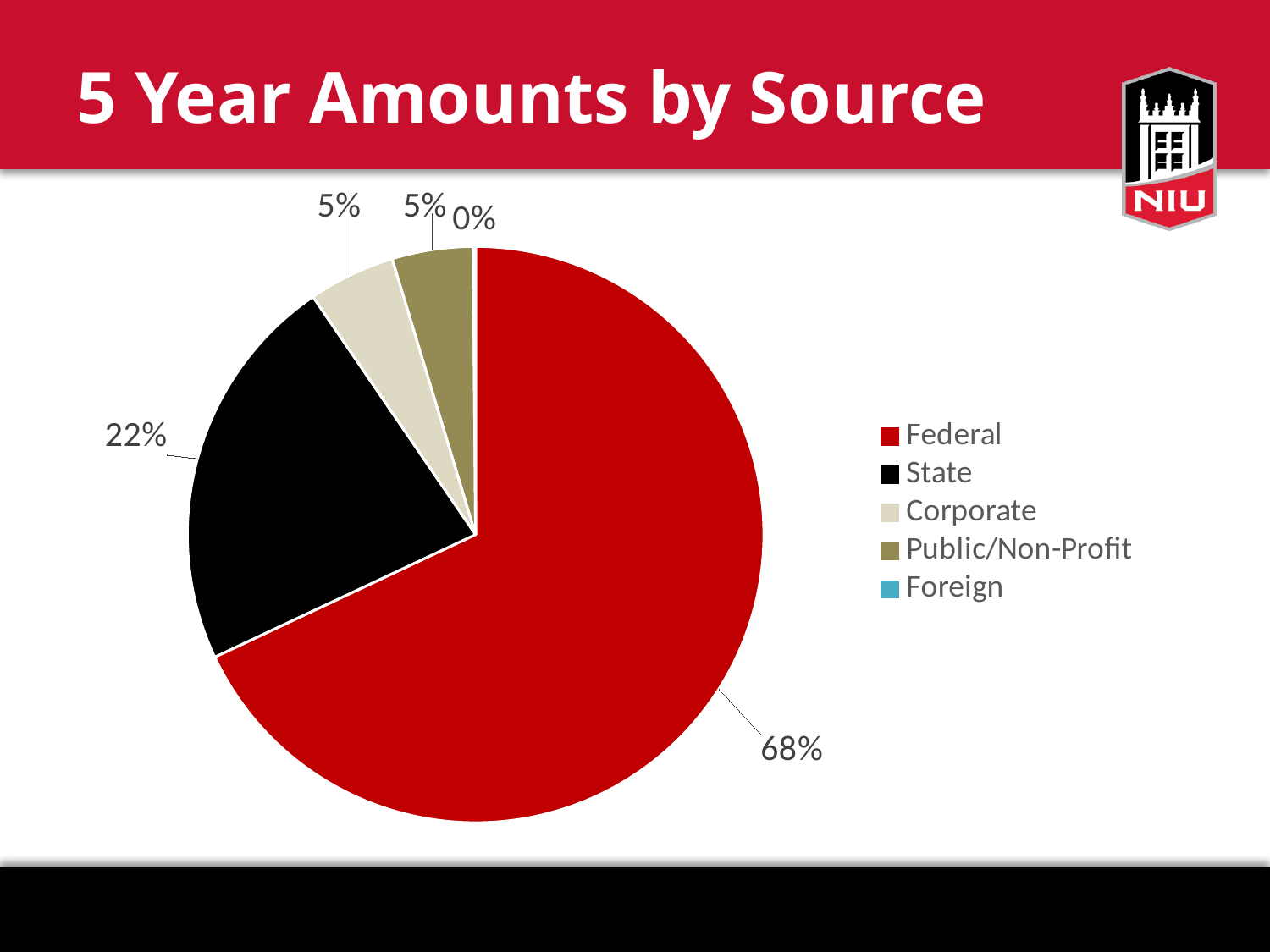
What is the title of the slide containing the chart? 5 Year Amounts by Source What percentage is shown for Corporate? 5% What percentage is shown for State? 22% Which source has the largest share of the pie? Federal How many sources does the legend list? 5 Which source has the smallest share of the pie? Foreign What share of the pie does Federal account for? 68% Which is larger, the share for State or the share for Corporate? State What kind of chart is shown on the slide? Pie chart What colour is the Federal slice in the pie chart? Red What percentage is shown for Foreign? 0% What is the difference in percentage points between Federal and State? 46